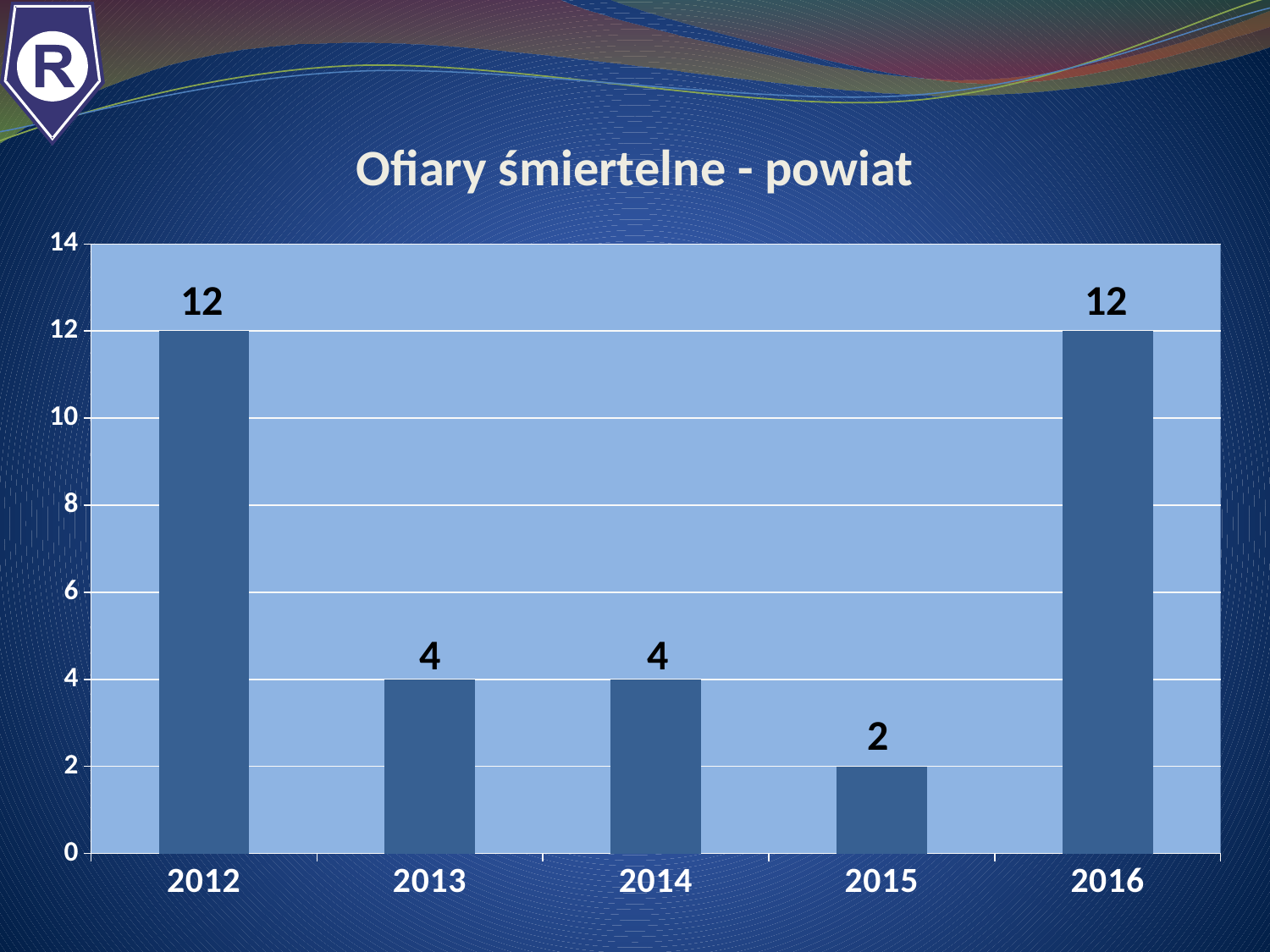
What is the value for 2013? 4 What is the difference between the values for 2012 and 2013? 8 Which is larger, the value for 2014 or the value for 2015? 2014 What is the title of the chart? Ofiary śmiertelne - powiat What is the value for 2015? 2 What kind of chart is shown on the slide? bar chart How many years are shown on the x axis? 5 Is the value for 2016 greater or less than 10? greater What is the difference between the values for 2016 and 2015? 10 Which year has the lowest value? 2015 Do the values rise or fall from 2012 to 2015? fall What is the value for 2012? 12